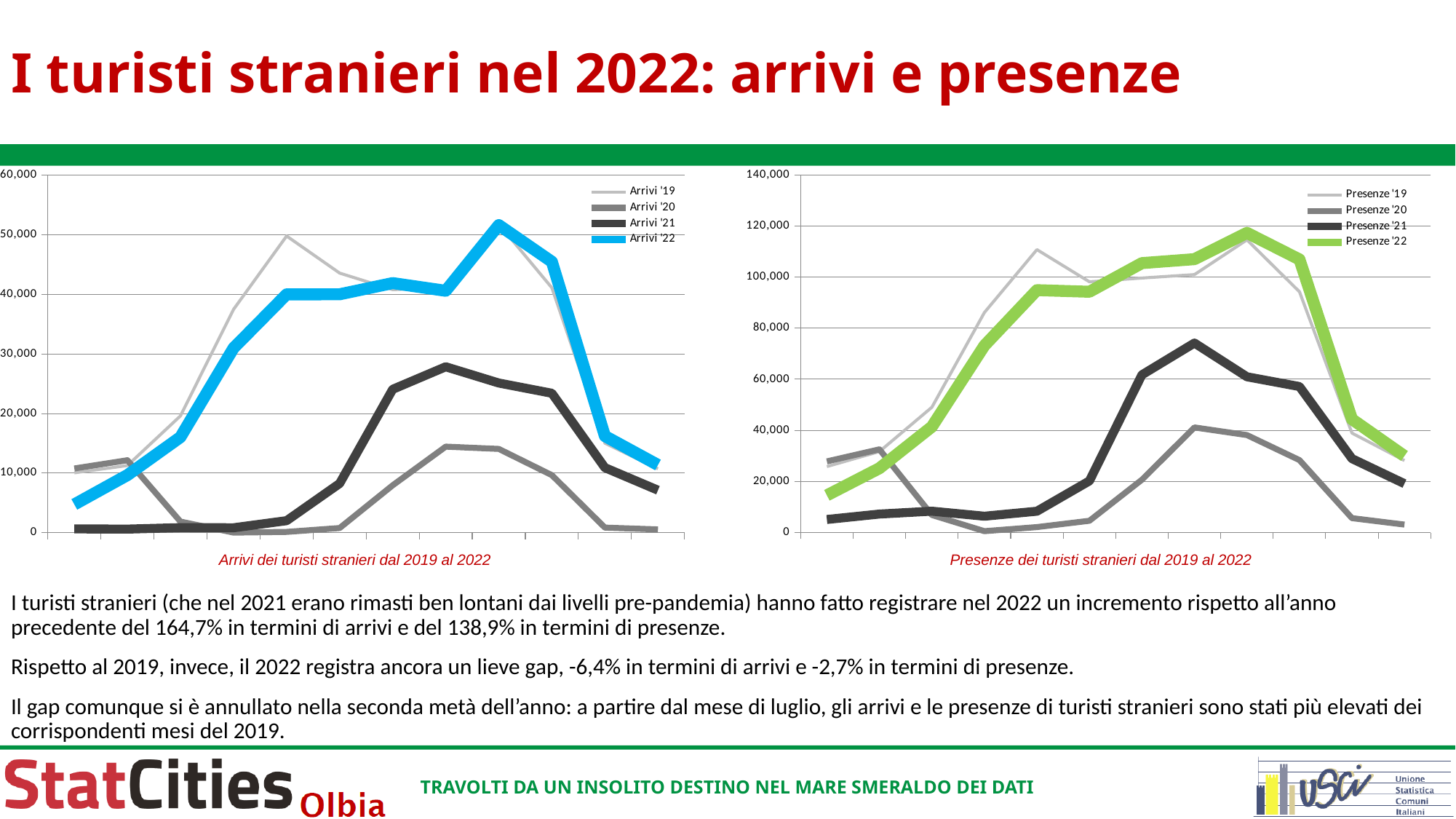
In the left chart, 'Arrivi dei turisti stranieri dal 2019 al 2022', what colour is the Arrivi '22 line? Blue In the right chart, 'Presenze dei turisti stranieri dal 2019 al 2022', which series has the lowest peak? Presenze '20 In the right chart, 'Presenze dei turisti stranieri dal 2019 al 2022', is the peak value of Presenze '21 greater or less than 80,000? less In the left chart, 'Arrivi dei turisti stranieri dal 2019 al 2022', is the peak value of Arrivi '22 greater or less than 50,000? greater How many data points does each series have in the left chart, 'Arrivi dei turisti stranieri dal 2019 al 2022'? 12 In the right chart, 'Presenze dei turisti stranieri dal 2019 al 2022', what colour is the Presenze '22 line? Green In the left chart, 'Arrivi dei turisti stranieri dal 2019 al 2022', which series has the lowest peak? Arrivi '20 In the right chart, 'Presenze dei turisti stranieri dal 2019 al 2022', is the peak value of Presenze '22 greater or less than 110,000? greater What kind of chart is the left chart, 'Arrivi dei turisti stranieri dal 2019 al 2022'? Line chart How many series does the legend of the right chart, 'Presenze dei turisti stranieri dal 2019 al 2022', list? 4